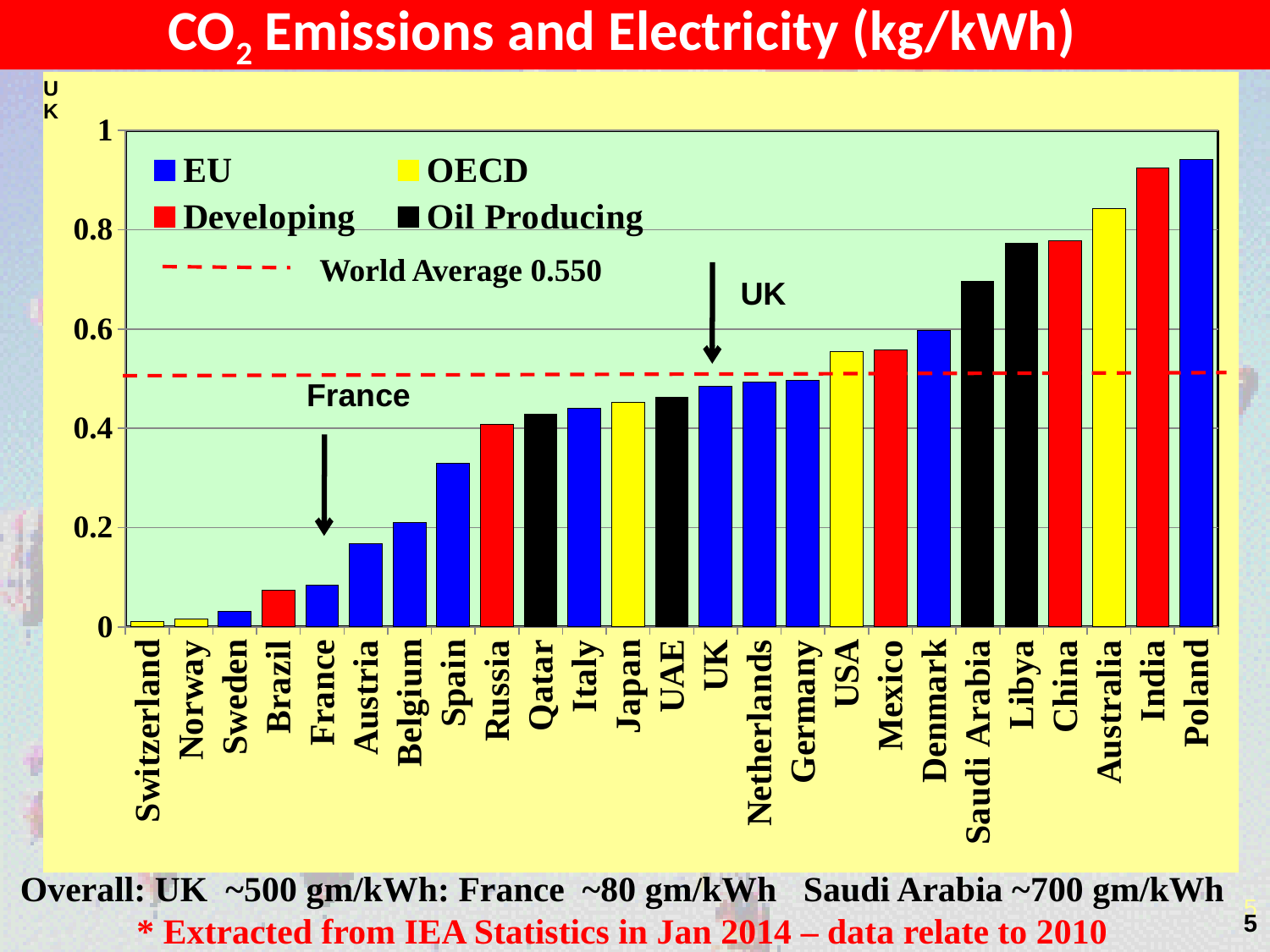
Do the bar values rise or fall moving from left to right along the x axis? rise Is the value for Saudi Arabia greater or less than 0.6? greater Is the value for France greater or less than 0.2? less What kind of chart is shown on the slide? bar chart Which country has the highest CO2 emissions value in the chart? Poland Is the value for Spain greater or less than 0.4? less How many countries are plotted along the x axis of the chart? 25 What colour represents the Developing group in the chart? red Which has the larger value, Germany or Spain? Germany What World Average value is stated in the chart legend? 0.550